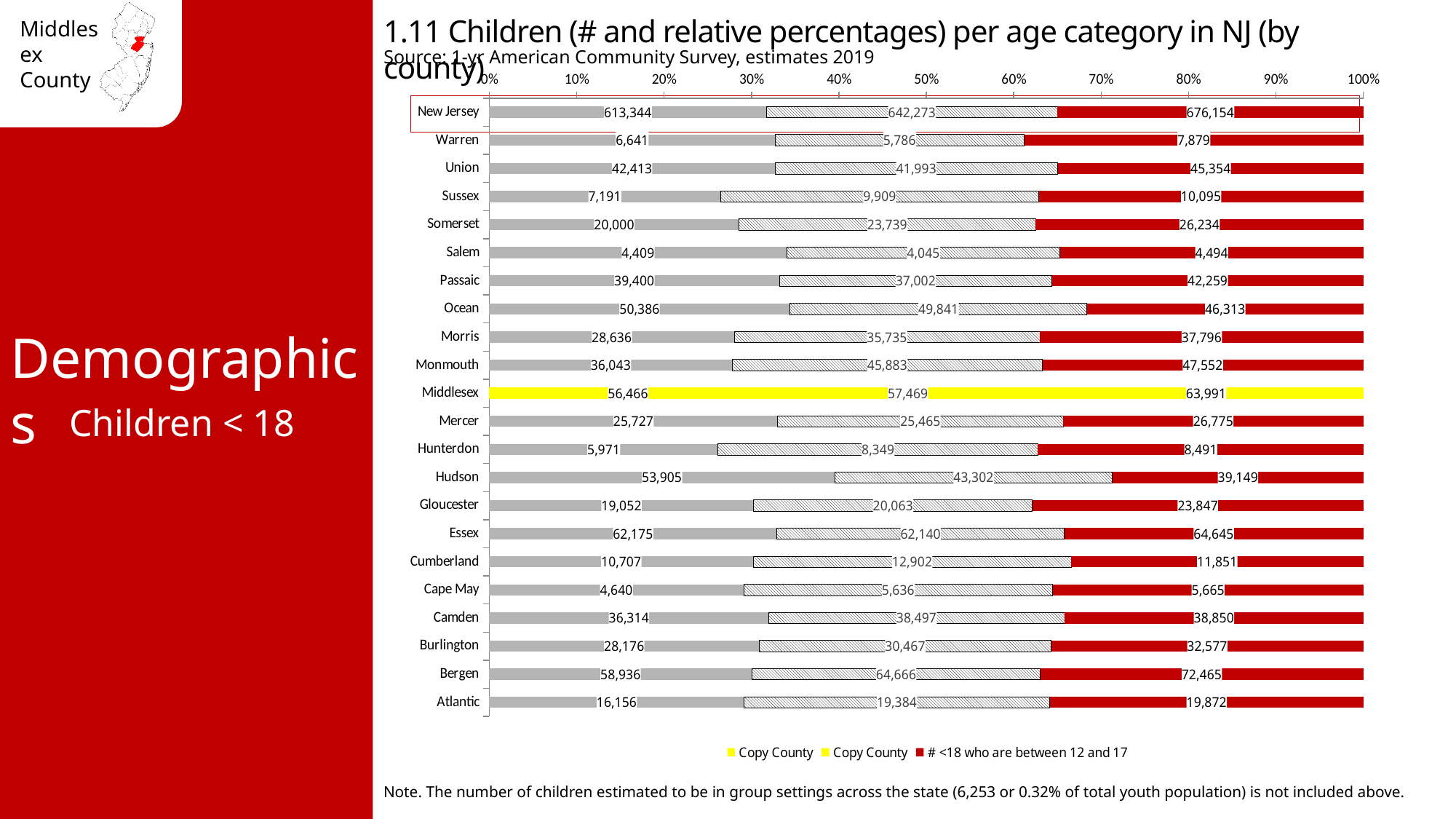
What is the value of the '# <18 who are between 12 and 17' series for Middlesex? 63,991 What is the value printed on the leftmost (first) segment of the Atlantic bar? 16,156 How many series does the legend list? 3 For Middlesex, what is the difference between the '# <18 who are between 12 and 17' value and the value on the leftmost segment? 7,525 Excluding the New Jersey total row, which county has the lowest '# <18 who are between 12 and 17' value? Salem Which has the larger '# <18 who are between 12 and 17' value, Bergen or Essex? Bergen What is the value printed on the middle segment of the Hudson bar? 43,302 What is the value printed on the leftmost (first) segment of the New Jersey bar? 613,344 How many rows (categories) are plotted on the chart? 22 Which row of the chart is highlighted in yellow? Middlesex What kind of chart is shown on the slide? Stacked bar chart What is the total of the three values printed on the Middlesex bar? 177,926